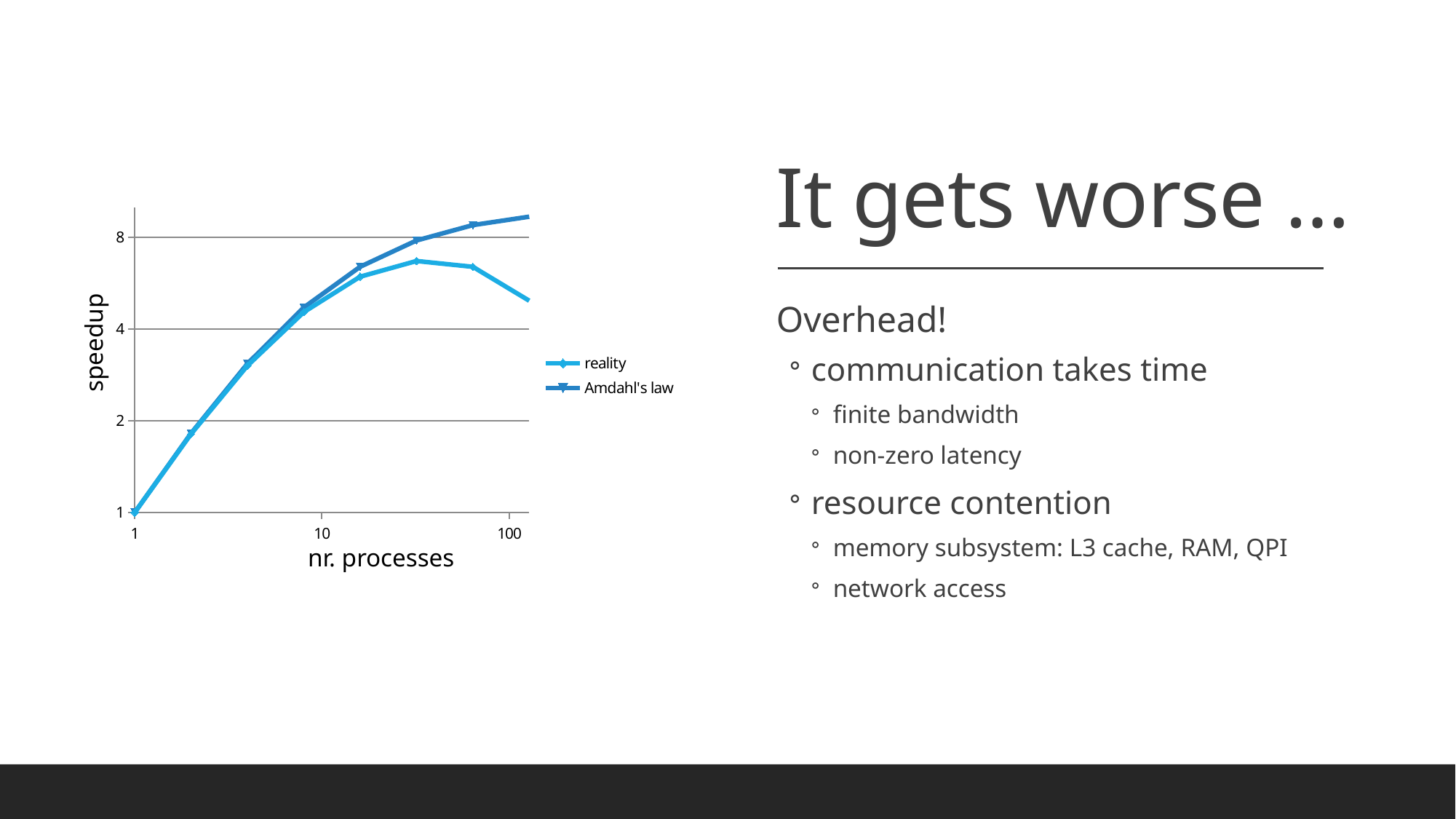
What is the label of the chart's x axis? nr. processes Does the Amdahl's law series rise or fall as the number of processes increases? rises What kind of chart is shown on the slide? line chart Does the reality series rise or fall over its last three points as the number of processes increases? falls What are the two series named in the chart's legend? reality and Amdahl's law Is the speedup of the reality series at 4 processes greater or less than 2? greater What is the speedup for both series at 1 process? 1 Is the speedup of the Amdahl's law series at its rightmost point greater or less than 8? greater Which series reaches the highest speedup on the chart? Amdahl's law Is the speedup of the reality series at its rightmost point greater or less than 8? less How many series does the chart's legend list? 2 At 100+ processes (the rightmost point), which series has the higher speedup, reality or Amdahl's law? Amdahl's law